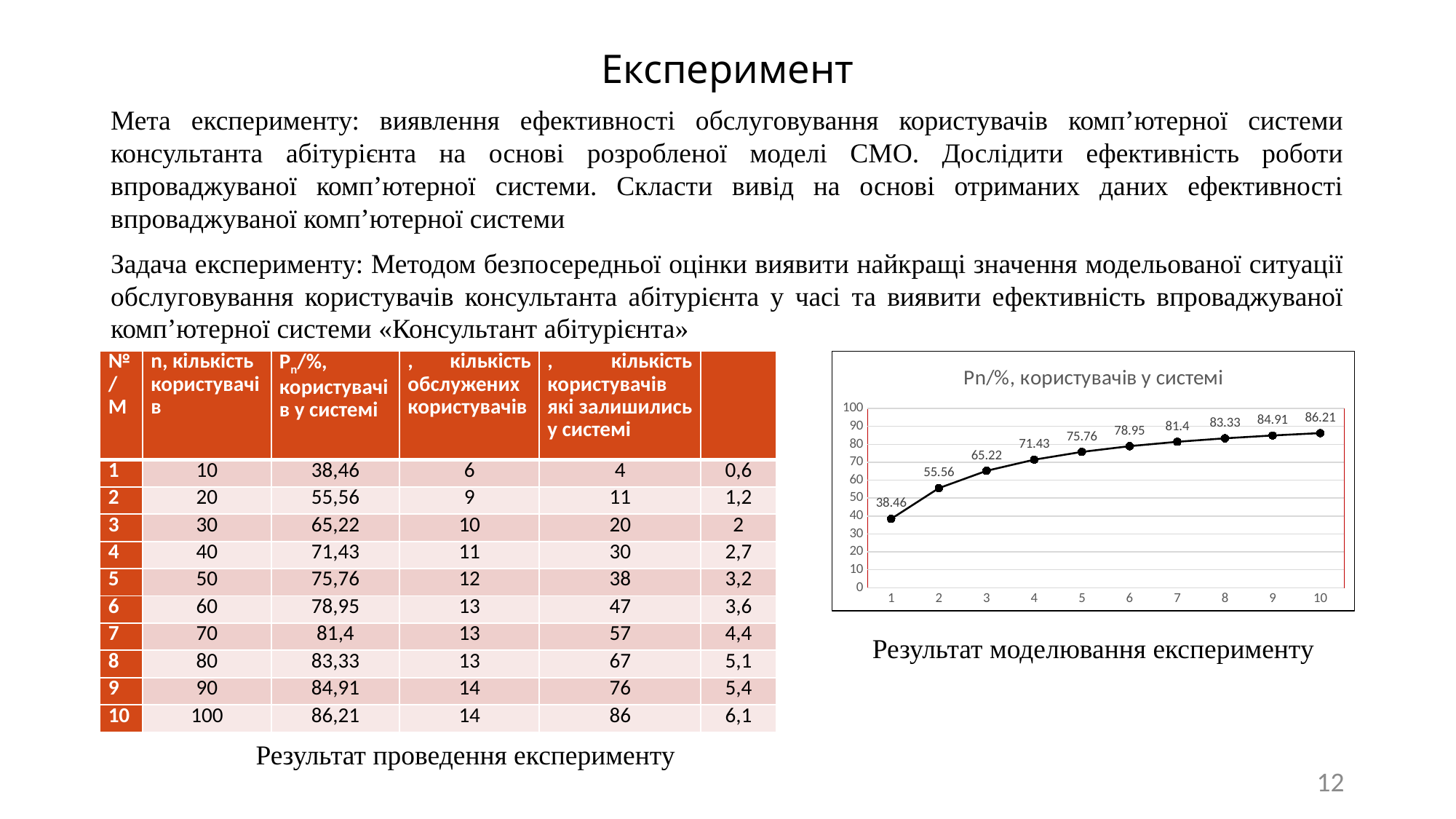
What is the title of the chart? Pn/%, користувачів у системі What type of chart is shown on the slide? line chart How many data points are plotted on the chart? 10 Which is larger, the value at point 3 or the value at point 7? point 7 Which point on the x axis has the highest value? 10 Which point on the x axis has the lowest value? 1 What is the value at point 5 on the chart? 75.76 What is the value at point 1 on the chart? 38.46 What is the difference between the values at point 2 and point 1? 17.1 Is the value at point 4 greater or less than 70? greater Do the values rise or fall as the x axis goes from 1 to 10? rise What is the value at point 10 on the chart? 86.21